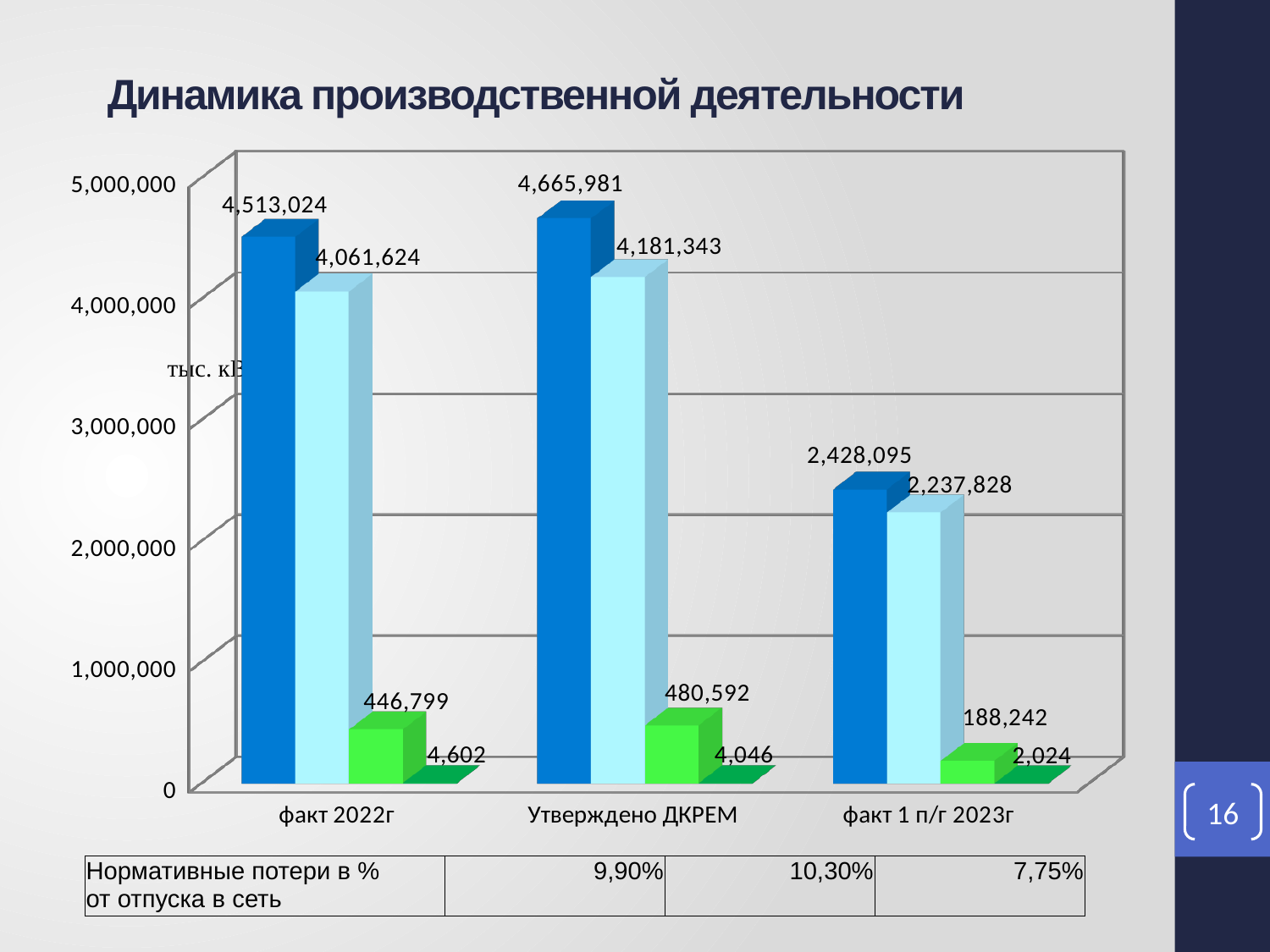
Which category has the lowest light blue bar? факт 1 п/г 2023г Which is larger: the light blue bar for факт 2022г or the light blue bar for факт 1 п/г 2023г? факт 2022г What is the value of the smallest (dark green) bar for Утверждено ДКРЕМ? 4,046 Which category has the highest dark blue bar? Утверждено ДКРЕМ What is the value of the light blue bar for Утверждено ДКРЕМ? 4,181,343 What type of chart is shown on the slide? bar chart What is the difference between the green bars for Утверждено ДКРЕМ and факт 2022г? 33,793 What is the value of the green bar for факт 1 п/г 2023г? 188,242 What is the value of the dark blue bar for факт 2022г? 4,513,024 How many categories are shown on the x axis? 3 Is the dark blue bar for факт 1 п/г 2023г greater or less than 2,000,000? greater What is the difference between the dark blue bars for Утверждено ДКРЕМ and факт 2022г? 152,957